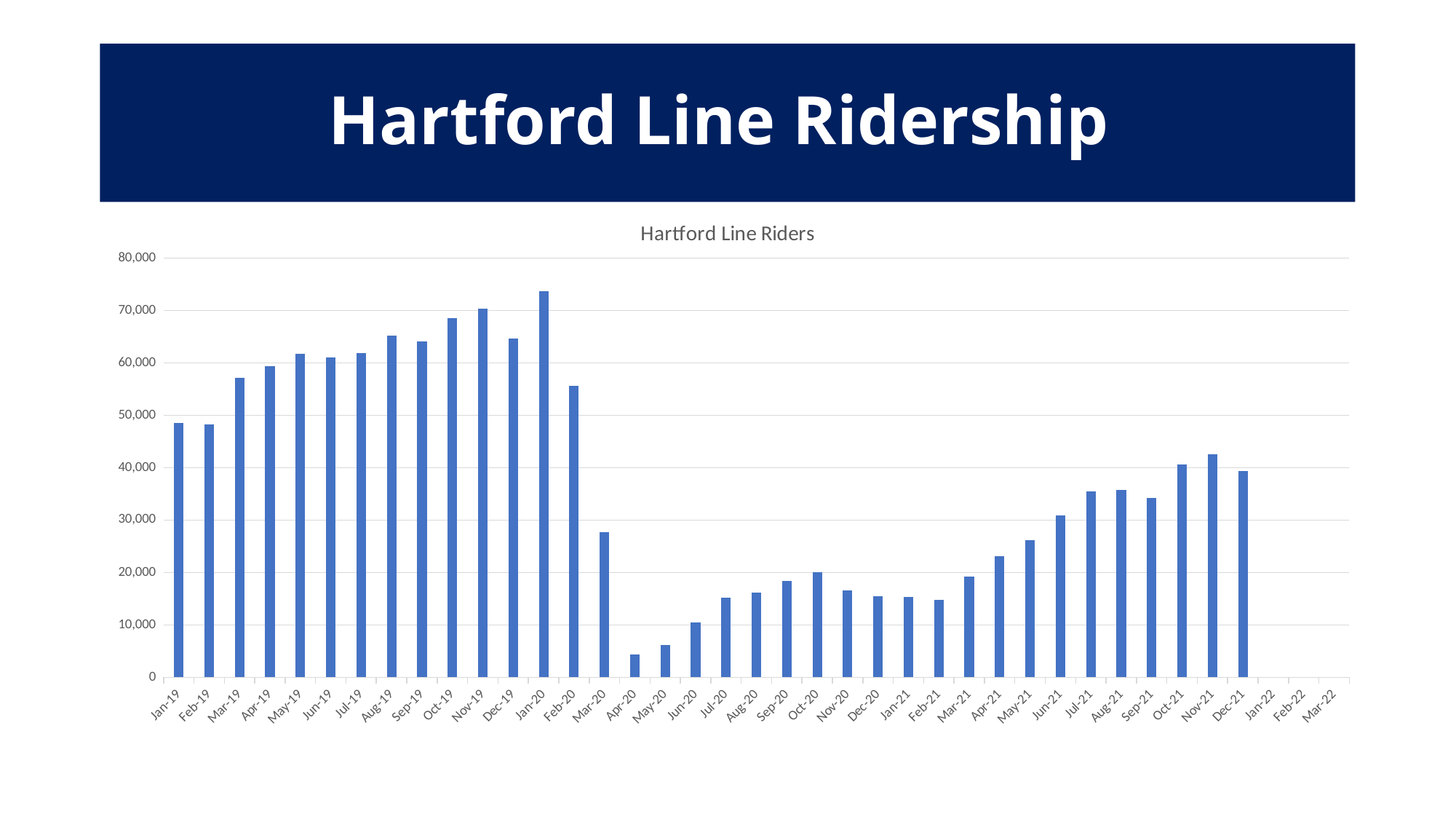
Is the value for Jan-19 greater or less than 50,000? less Which is larger, the value for Jan-20 or the value for Feb-20? Jan-20 Is the value for Mar-20 greater or less than 30,000? less Which is larger, the value for Nov-21 or the value for Dec-21? Nov-21 Is the value for Nov-21 greater or less than 40,000? greater What kind of chart is shown on the slide? Bar chart What is the title printed above the chart's plot area? Hartford Line Riders Which month has the highest ridership? Jan-20 Do the values rise or fall from Apr-20 to Oct-20? Rise Which month has the lowest ridership? Apr-20